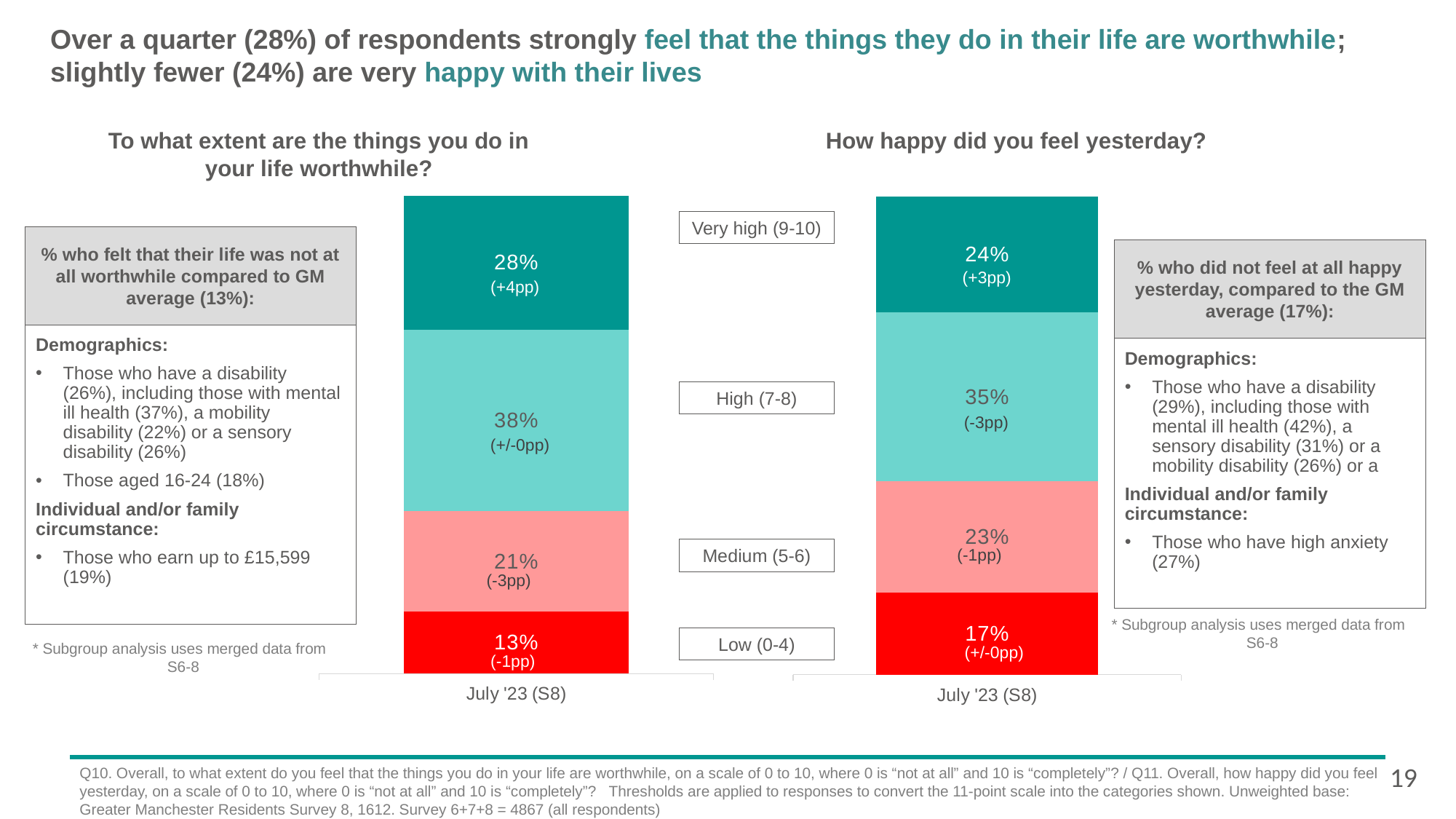
How many categories are shown in each stacked bar on the slide? 4 What type of chart is used on this slide? Stacked bar chart In the chart 'To what extent are the things you do in your life worthwhile?', which category has the largest share of respondents? High (7-8) In the chart 'How happy did you feel yesterday?', what percentage of respondents are in the Low (0-4) category? 17% In the chart 'To what extent are the things you do in your life worthwhile?', what is the difference between the High (7-8) and Medium (5-6) percentages? 17 percentage points In the chart 'To what extent are the things you do in your life worthwhile?', what change from the previous survey is shown for the Very high (9-10) category? +4pp In the chart 'To what extent are the things you do in your life worthwhile?', what percentage of respondents are in the Very high (9-10) category? 28% In the chart 'How happy did you feel yesterday?', which category has the smallest share of respondents? Low (0-4) In the chart 'How happy did you feel yesterday?', what is the difference between the Very high (9-10) and Low (0-4) percentages? 7 percentage points In the chart 'How happy did you feel yesterday?', what percentage of respondents are in the High (7-8) category? 35% In the chart 'To what extent are the things you do in your life worthwhile?', which category has the smallest share of respondents? Low (0-4) Which is larger: the Very high (9-10) share in the 'worthwhile' chart or the Very high (9-10) share in the 'happy yesterday' chart? The 'worthwhile' chart (28%)